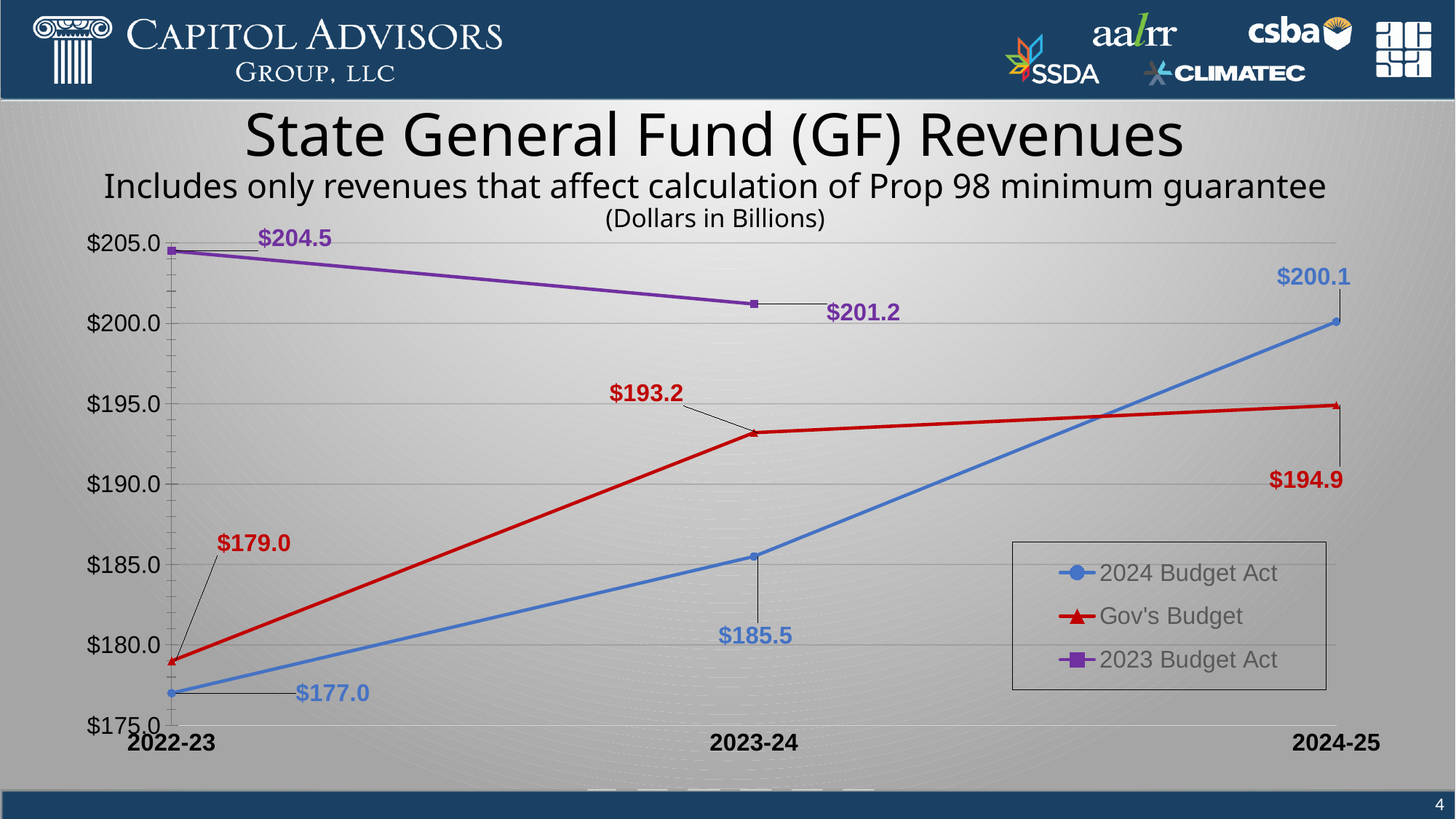
Which series has the highest value in 2022-23? 2023 Budget Act How many series does the legend list? 3 What is the value for the 2024 Budget Act in 2024-25? $200.1 What is the difference between the 2024 Budget Act and Gov's Budget values in 2024-25? $5.2 In 2023-24, which is larger: the Gov's Budget value or the 2024 Budget Act value? Gov's Budget Does the 2023 Budget Act series rise or fall from 2022-23 to 2023-24? fall Which series has the lowest value in 2023-24? 2024 Budget Act What is the value for the 2024 Budget Act in 2022-23? $177.0 What is the value for the 2023 Budget Act in 2022-23? $204.5 How many fiscal years are shown on the x axis? 3 What kind of chart is shown on the slide? line chart What is the value for Gov's Budget in 2023-24? $193.2